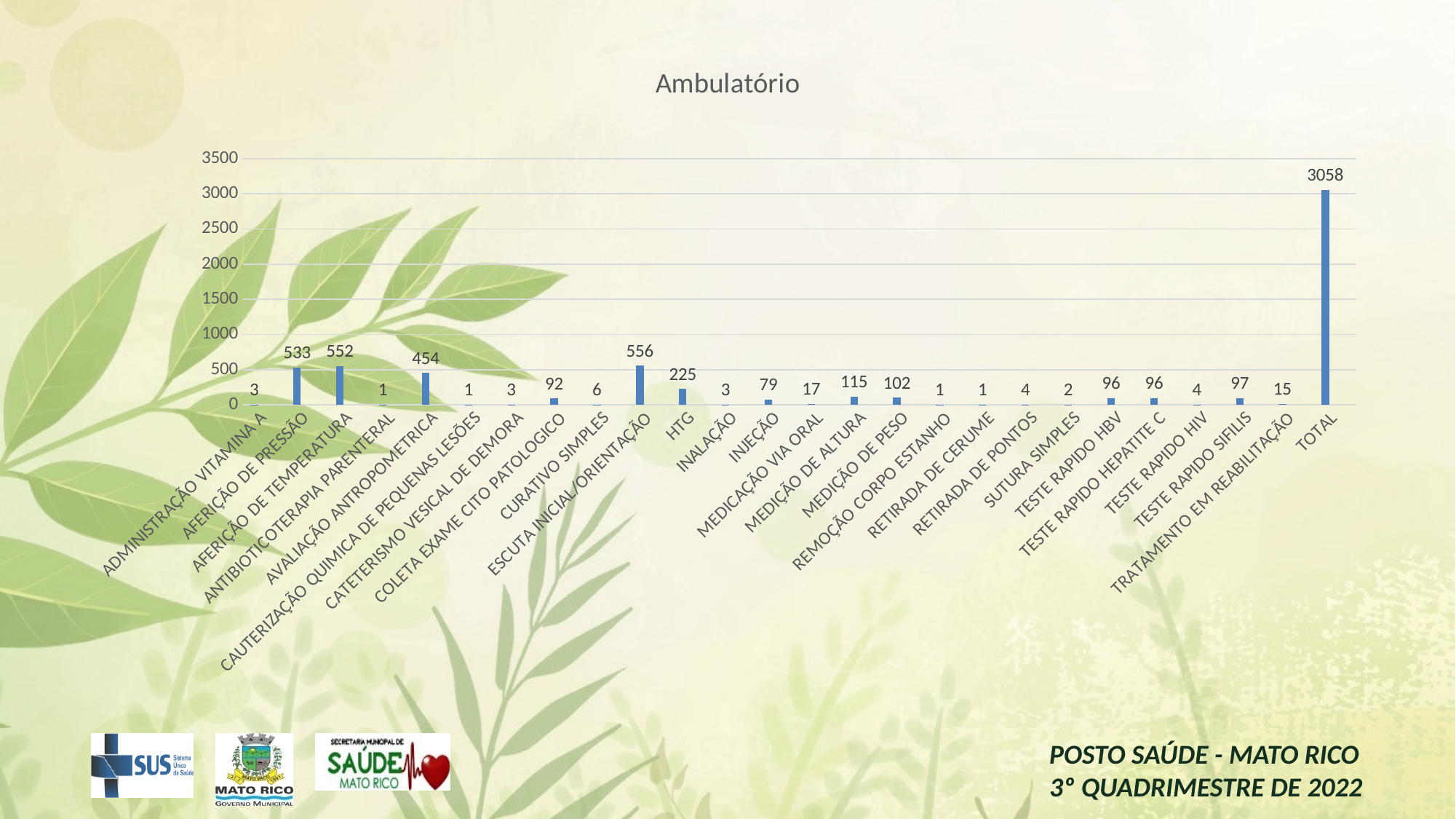
What is the value for INJEÇÃO? 79 What is the difference between the values for AFERIÇÃO DE TEMPERATURA and AVALIAÇÃO ANTROPOMETRICA? 98 What is the value for HTG? 225 Excluding the TOTAL bar, which category has the highest value? ESCUTA INICIAL/ORIENTAÇÃO What is the value for TESTE RAPIDO SIFILIS? 97 Is the value for TOTAL greater or less than 3000? greater What type of chart is shown on the slide? bar chart What is the value for AFERIÇÃO DE PRESSÃO? 533 Which is larger, the value for MEDIÇÃO DE ALTURA or the value for MEDIÇÃO DE PESO? MEDIÇÃO DE ALTURA What is the title of the chart? Ambulatório What is the value shown for TOTAL? 3058 How many categories are shown on the x axis, including TOTAL? 26